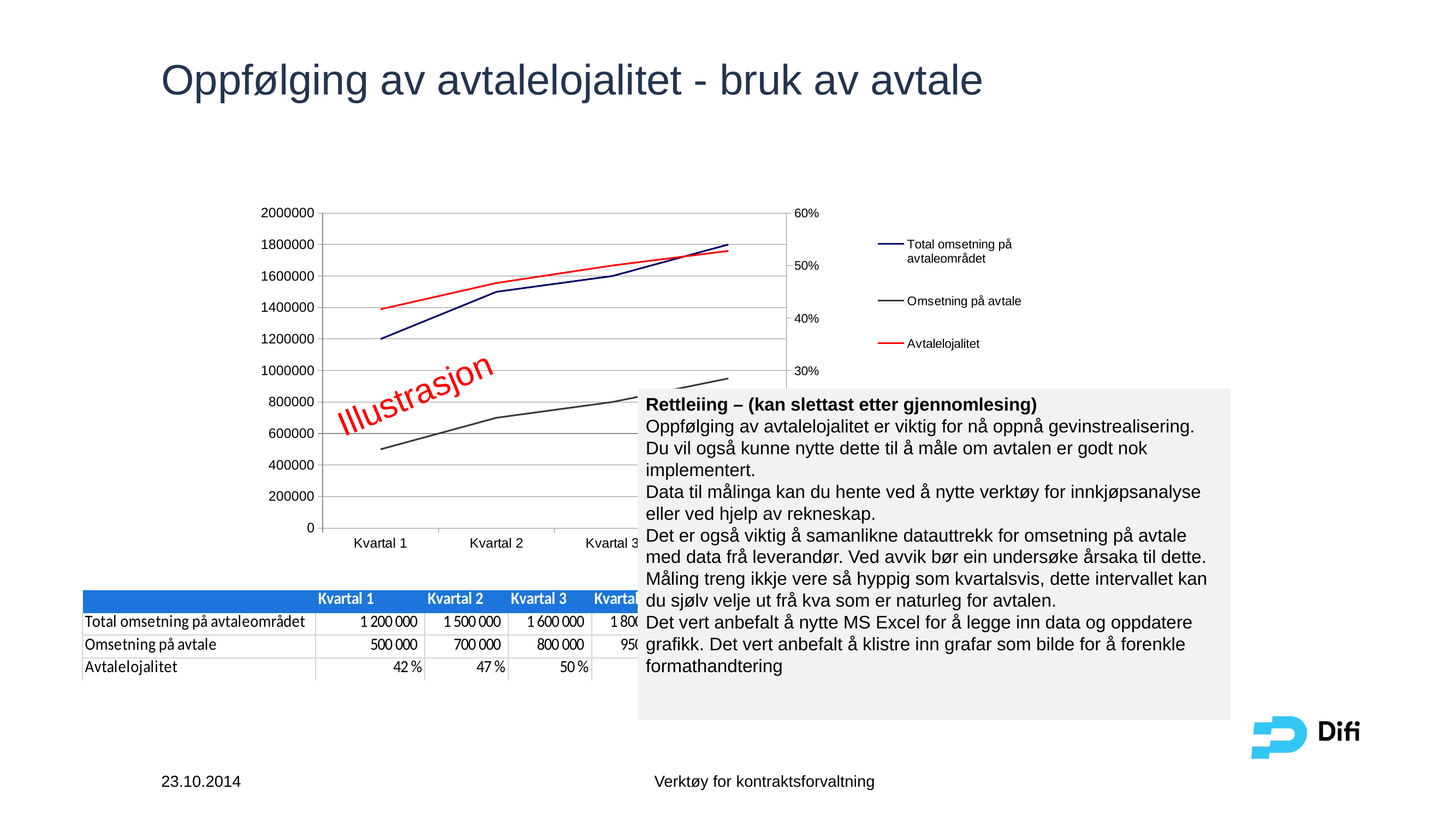
What colour is the Avtalelojalitet line in the chart? red What kind of chart is shown on the slide? line chart What is the difference between Total omsetning på avtaleområdet and Omsetning på avtale in Kvartal 1? 700 000 Is the Avtalelojalitet in Kvartal 1 greater or less than 40%? greater Is the value for Omsetning på avtale in Kvartal 1 greater or less than 600000? less What is the difference in Omsetning på avtale between Kvartal 3 and Kvartal 1? 300 000 Does Total omsetning på avtaleområdet rise or fall from Kvartal 1 to Kvartal 3? rise Which is larger for Total omsetning på avtaleområdet: Kvartal 2 or Kvartal 3? Kvartal 3 What is the value of Omsetning på avtale in Kvartal 2? 700 000 How many series does the chart legend list? 3 What is the value of Total omsetning på avtaleområdet in Kvartal 1? 1 200 000 What is the Avtalelojalitet in Kvartal 3? 50 %